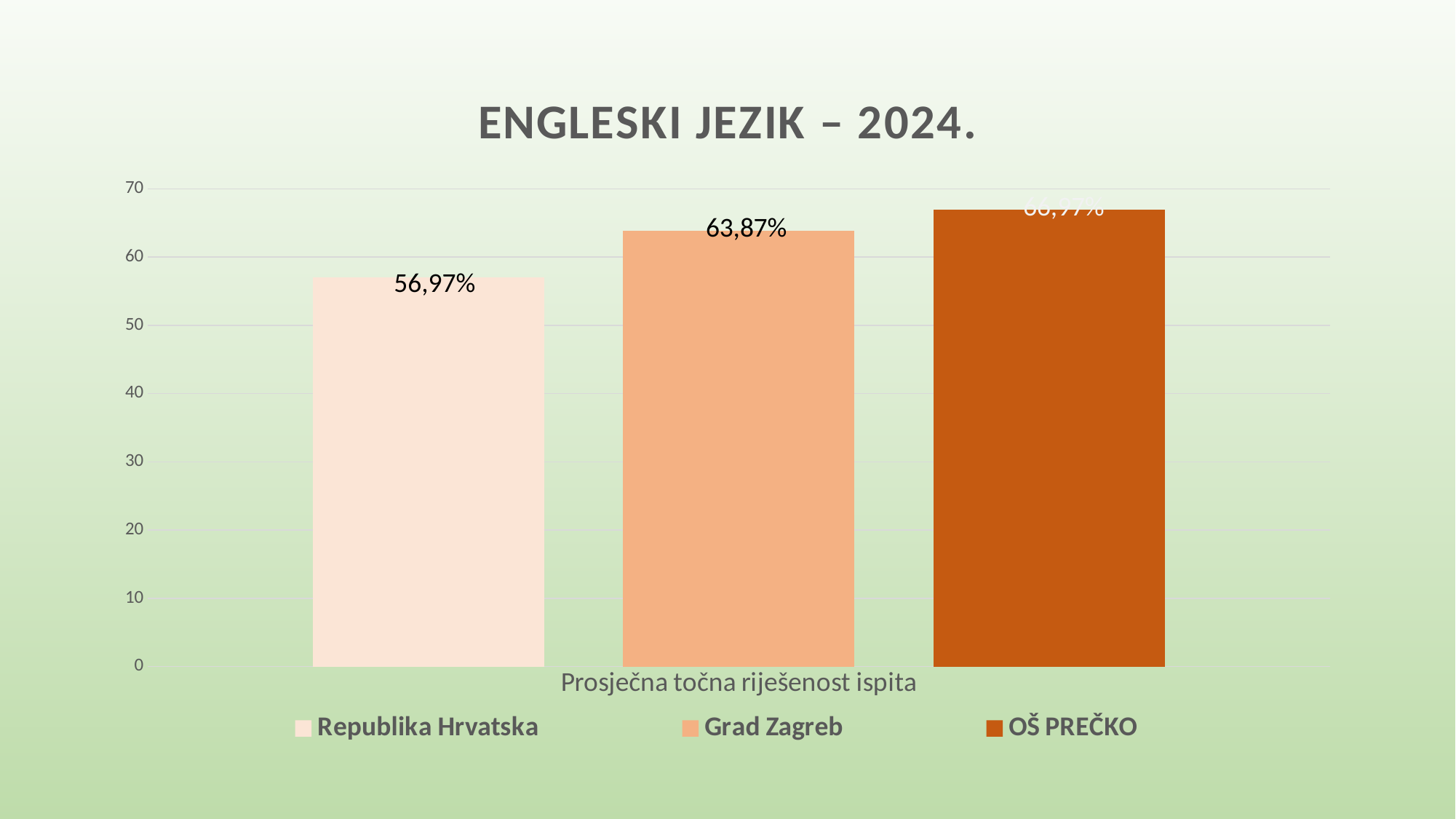
What is the value for OŠ PREČKO? 66,97% Is the value for Republika Hrvatska greater or less than 60? less What is the difference between the values for Grad Zagreb and Republika Hrvatska? 6,90% What kind of chart is shown on the slide? bar chart Which series has the highest value? OŠ PREČKO How many series does the legend list? 3 What is the difference between the values for OŠ PREČKO and Republika Hrvatska? 10,00% Which is larger, the value for Grad Zagreb or the value for Republika Hrvatska? Grad Zagreb What is the value for Grad Zagreb? 63,87% What is the title of the chart? ENGLESKI JEZIK – 2024. Which series has the lowest value? Republika Hrvatska What is the value for Republika Hrvatska? 56,97%